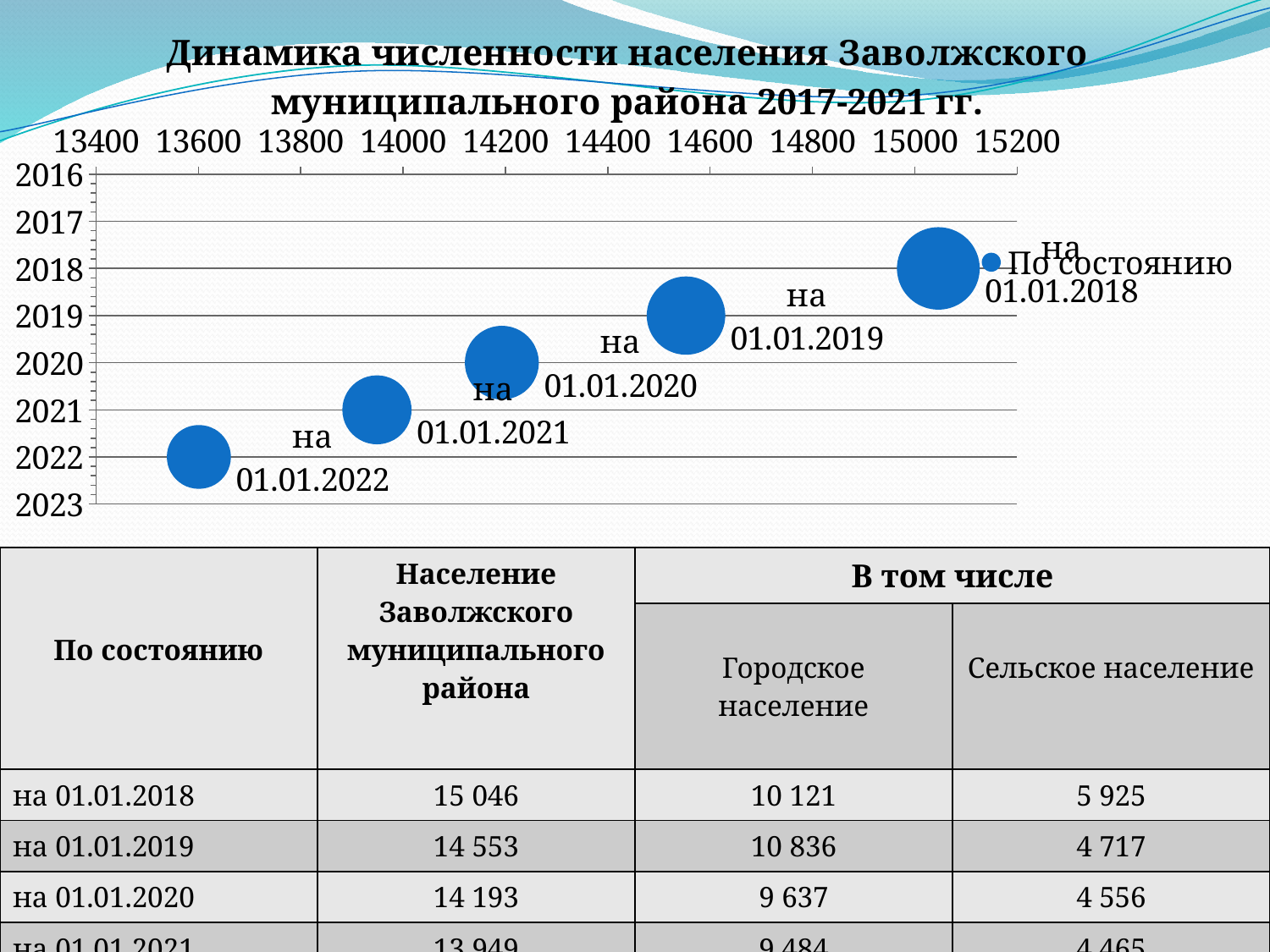
Which data point has the lowest population value on the chart? на 01.01.2022 Is the value for на 01.01.2018 greater or less than 15000? greater What is the title of the chart? Динамика численности населения Заволжского муниципального района 2017-2021 гг. Is the value for на 01.01.2021 greater or less than 14000? less Is the value for на 01.01.2019 greater or less than 14400? greater Does the population value rise or fall from на 01.01.2018 to на 01.01.2022? fall How many data points (bubbles) are plotted on the chart? 5 Which data point has the highest population value on the chart? на 01.01.2018 What is the name of the series shown in the chart legend? По состоянию How many series does the chart legend list? 1 What kind of chart is shown on the slide? bubble chart